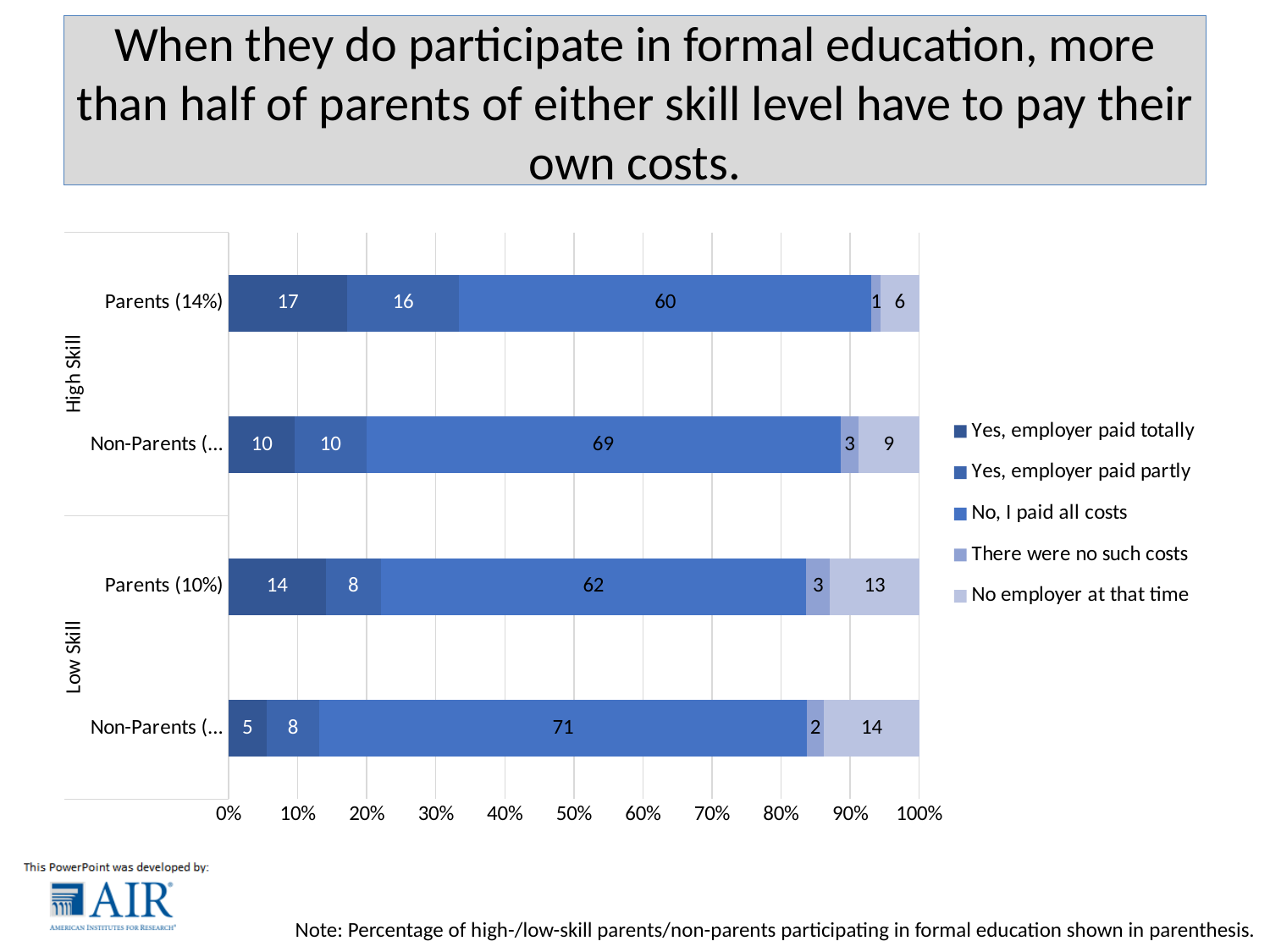
Which category has the lowest value for "Yes, employer paid totally"? Low Skill Non-Parents How many series does the legend list? 5 Which is larger: the "Yes, employer paid partly" value for High Skill Parents (14%) or for Low Skill Parents (10%)? High Skill Parents (14%) What is the value for "There were no such costs" for High Skill Non-Parents? 3 What is the value for "Yes, employer paid totally" for Low Skill Non-Parents? 5 Which category has the highest value for "No, I paid all costs"? Low Skill Non-Parents What type of chart is shown on the slide? Stacked bar chart What is the value for "No, I paid all costs" for High Skill Parents (14%)? 60 Which legend entry is shown in the darkest blue colour? Yes, employer paid totally How many category bars are plotted in the chart? 4 What is the difference between the "No, I paid all costs" values for High Skill Non-Parents and High Skill Parents (14%)? 9 What is the value for "No employer at that time" for Low Skill Parents (10%)? 13